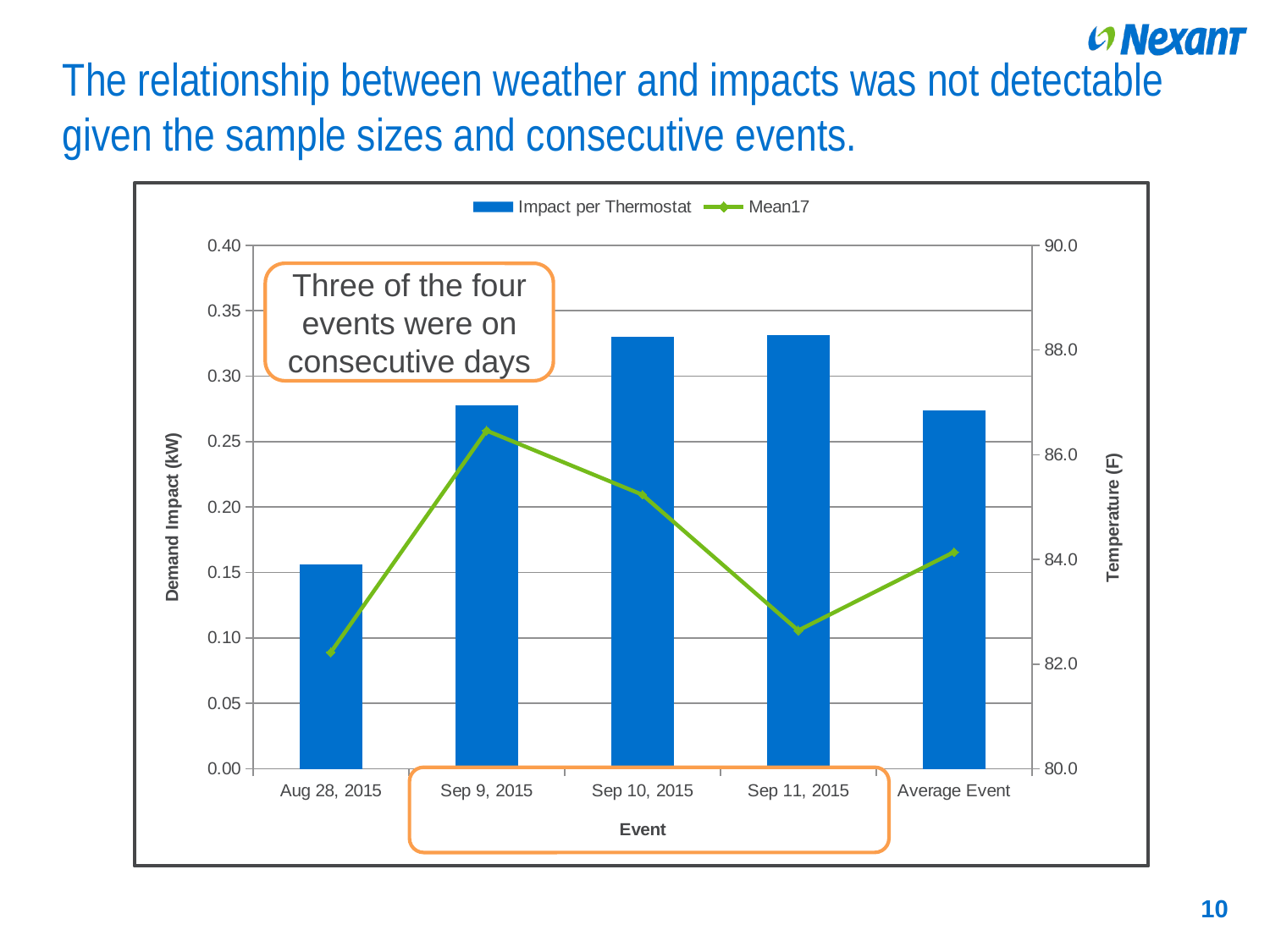
What kind of chart is shown on the slide? A combined bar and line chart Is the Mean17 temperature for Sep 11, 2015 greater or less than 84.0? less Which event has the highest Mean17 temperature? Sep 9, 2015 How many series does the legend list? 2 Which has the larger Impact per Thermostat, Sep 10, 2015 or Average Event? Sep 10, 2015 Is the Impact per Thermostat for Sep 10, 2015 greater or less than 0.30? greater Which event has the lowest Impact per Thermostat bar? Aug 28, 2015 Which has the larger Impact per Thermostat, Sep 9, 2015 or Aug 28, 2015? Sep 9, 2015 How many categories are shown on the x axis? 5 What is the title of the left vertical axis? Demand Impact (kW) Is the Impact per Thermostat for Aug 28, 2015 greater or less than 0.20? less